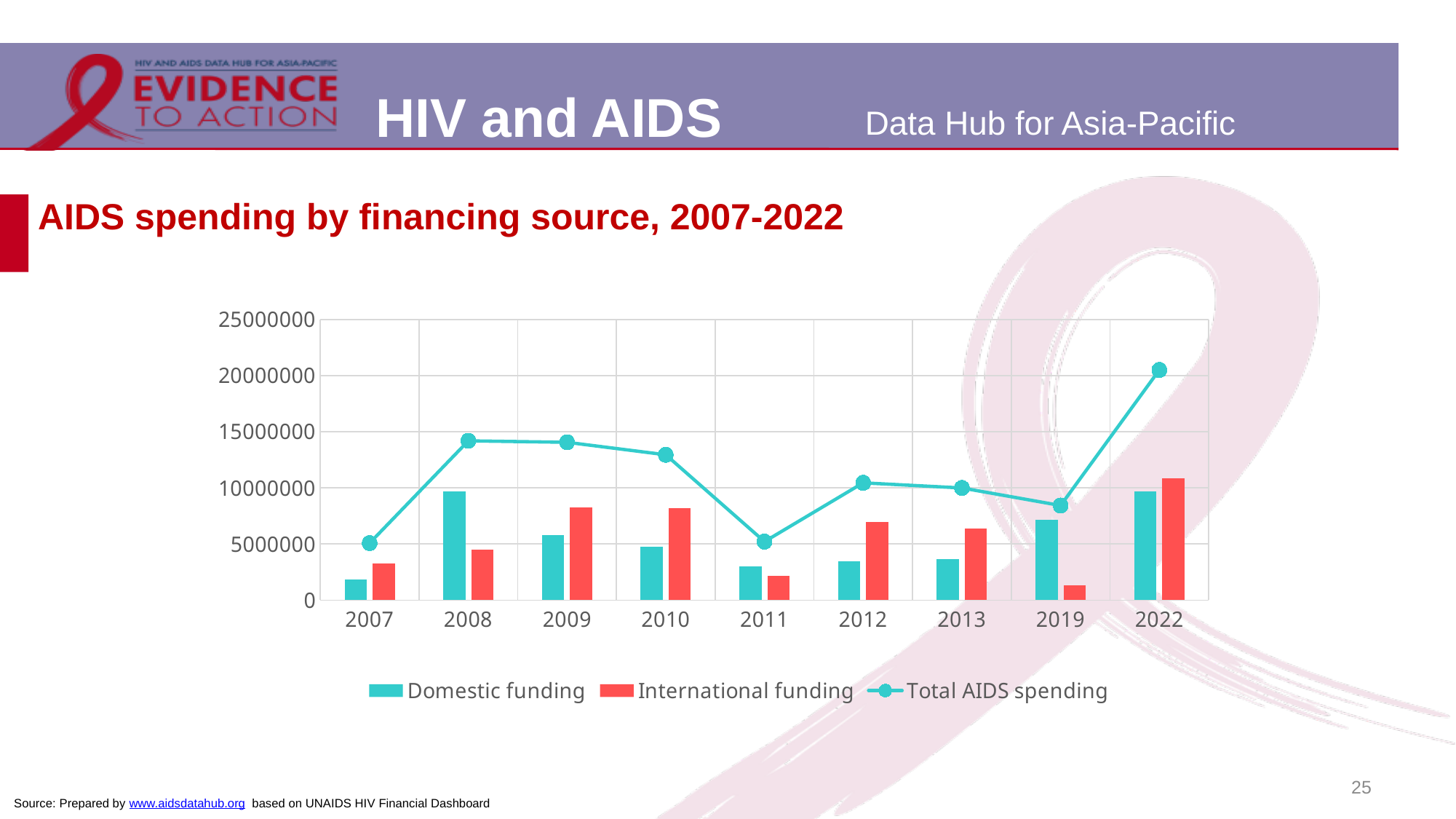
In 2019, which is larger: Domestic funding or International funding? Domestic funding What kind of chart is shown on the slide? Bar and line chart How many years are shown on the x axis of the chart? 9 In which year is Domestic funding lowest? 2007 In 2009, which is larger: Domestic funding or International funding? International funding How many series does the chart's legend list? 3 Is the value for International funding in 2022 greater or less than 10000000? greater In which year is Total AIDS spending highest? 2022 In which year is International funding highest? 2022 In which year is International funding lowest? 2019 Is the value for Total AIDS spending in 2008 greater or less than 15000000? less Does Total AIDS spending rise or fall from 2008 to 2011? Fall